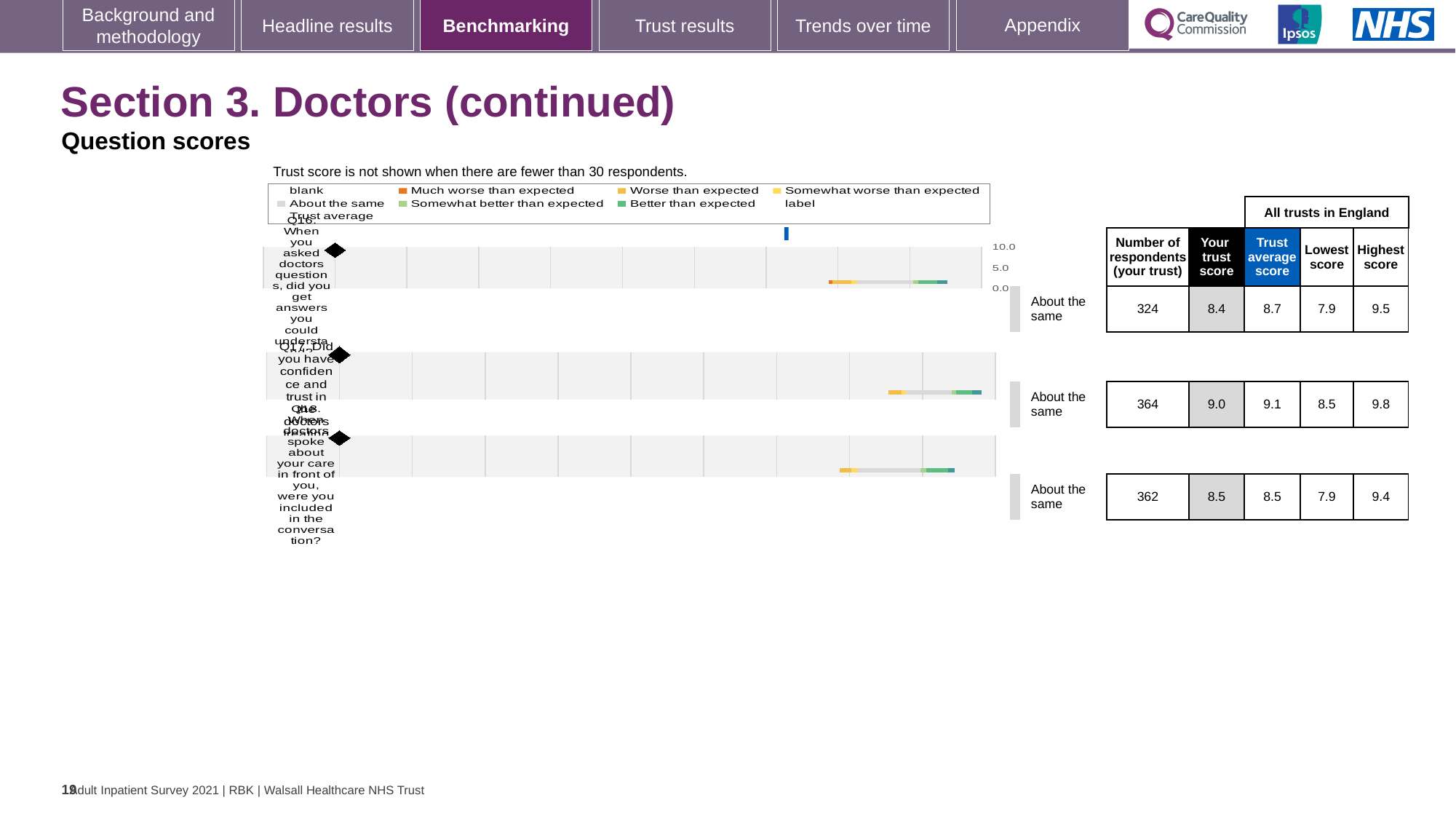
What kind of chart is used to show the question scores on this slide? bar chart What benchmark category is shown next to each of the three questions? About the same What is the difference between the highest score (9.8) and the lowest score (8.5) for Q17? 1.3 What is the trust average score for Q17 (Did you have confidence and trust in the doctors treating you)? 9.1 Which question has the lowest 'Your trust score'? Q16 Which question has the highest 'Your trust score'? Q17 What is the 'Your trust score' for Q16 (When you asked doctors questions, did you get answers you could understand)? 8.4 What is the highest score across all trusts in England for Q16? 9.5 How many respondents from your trust answered Q18? 362 How many questions (categories) are plotted in the chart? 3 Is the trust average marker for Q17 greater or less than 5.0 on the axis? greater For Q16, which is larger: your trust score or the trust average score? Trust average score